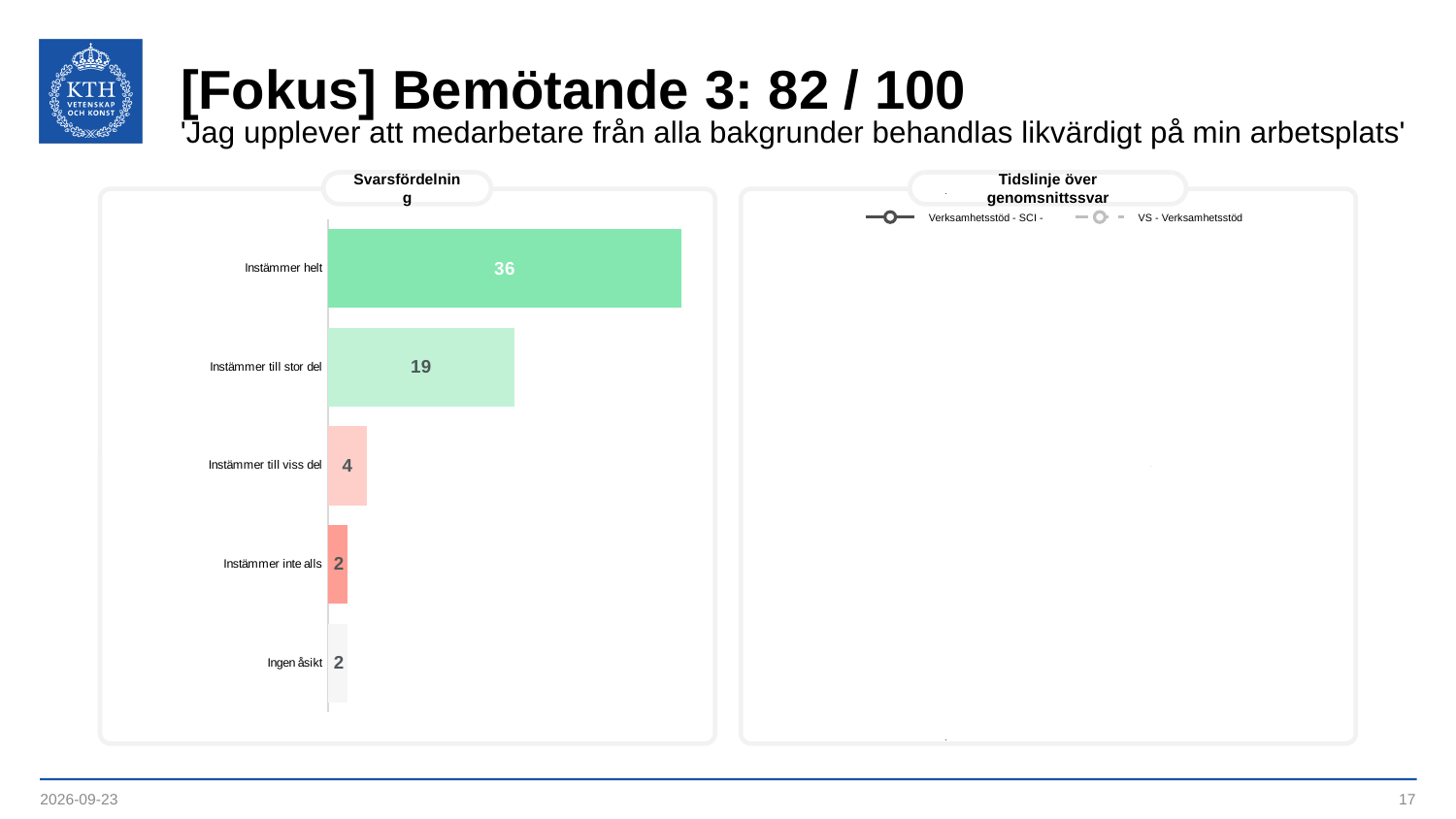
How many categories are shown in the Svarsfördelning chart? 5 In the Svarsfördelning chart, which category has the highest value? Instämmer helt In the Svarsfördelning chart, what is the difference between the values for 'Instämmer till stor del' and 'Instämmer till viss del'? 15 In the Svarsfördelning chart, which is larger: the value for 'Instämmer till stor del' or 'Instämmer till viss del'? Instämmer till stor del In the Svarsfördelning chart, what is the value for 'Instämmer till viss del'? 4 In the Svarsfördelning chart, what is the value for 'Ingen åsikt'? 2 In the Svarsfördelning chart, what is the value for 'Instämmer helt'? 36 How many series does the legend of the 'Tidslinje över genomsnittssvar' chart list? 2 In the Svarsfördelning chart, what is the value for 'Instämmer inte alls'? 2 In the Svarsfördelning chart, what is the difference between the values for 'Instämmer helt' and 'Instämmer till stor del'? 17 In the Svarsfördelning chart, what is the value for 'Instämmer till stor del'? 19 What kind of chart is the Svarsfördelning chart? Bar chart